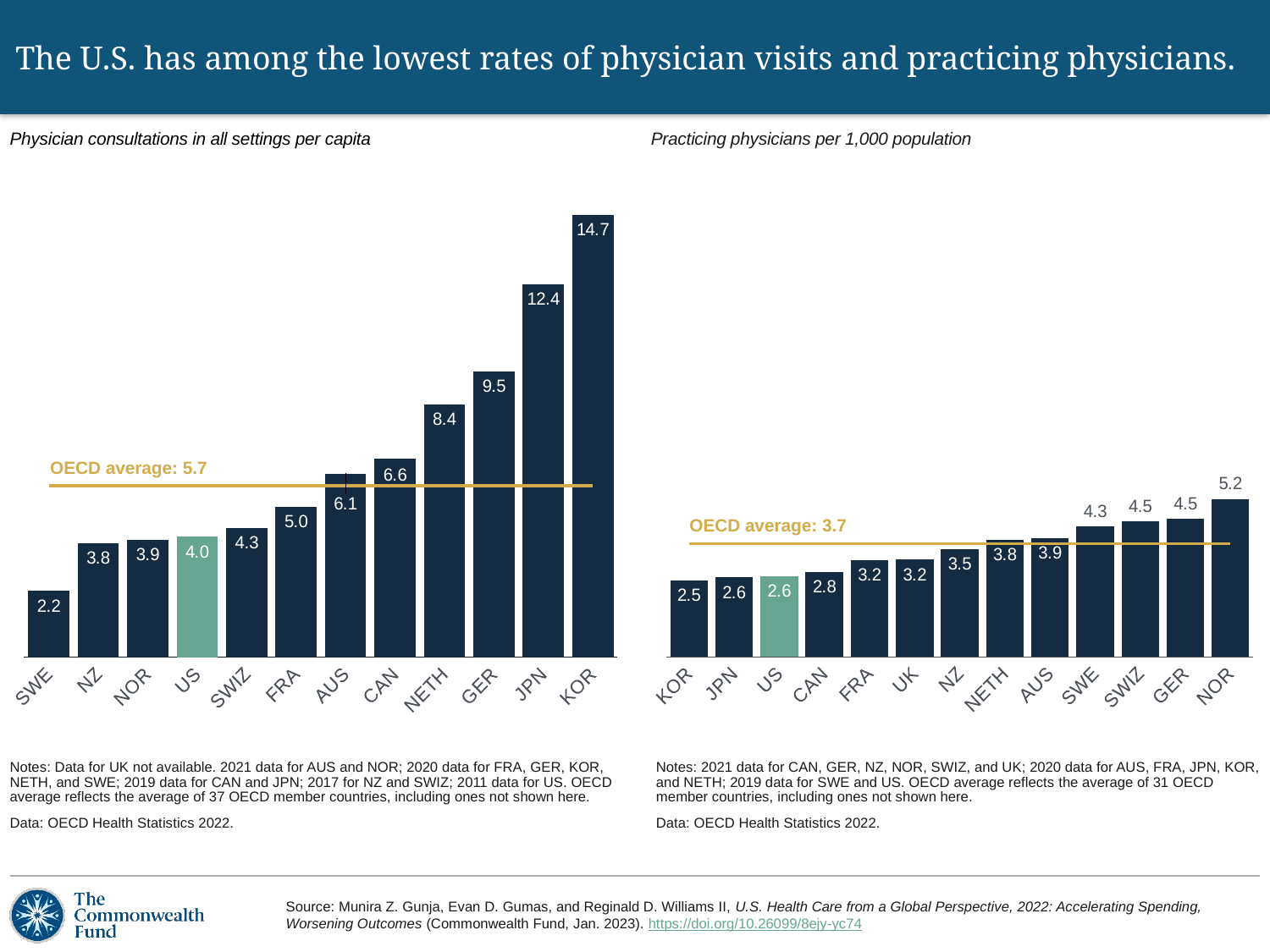
In the 'Practicing physicians per 1,000 population' chart, what is the value for NOR? 5.2 In the 'Practicing physicians per 1,000 population' chart, what is the difference between NOR and the US? 2.6 In the 'Practicing physicians per 1,000 population' chart, how many countries are shown? 13 In the 'Practicing physicians per 1,000 population' chart, which is larger, the value for NETH or the value for CAN? NETH In the 'Physician consultations in all settings per capita' chart, which country has the lowest value? SWE In the 'Physician consultations in all settings per capita' chart, which country has the highest value? KOR In the 'Physician consultations in all settings per capita' chart, what is the OECD average shown? 5.7 In the 'Physician consultations in all settings per capita' chart, how many countries are shown? 12 In the 'Physician consultations in all settings per capita' chart, what is the difference between KOR and JPN? 2.3 In the 'Physician consultations in all settings per capita' chart, what is the value for the US? 4.0 What type of chart is used on the slide? Bar chart In the 'Practicing physicians per 1,000 population' chart, which country has the lowest value? KOR